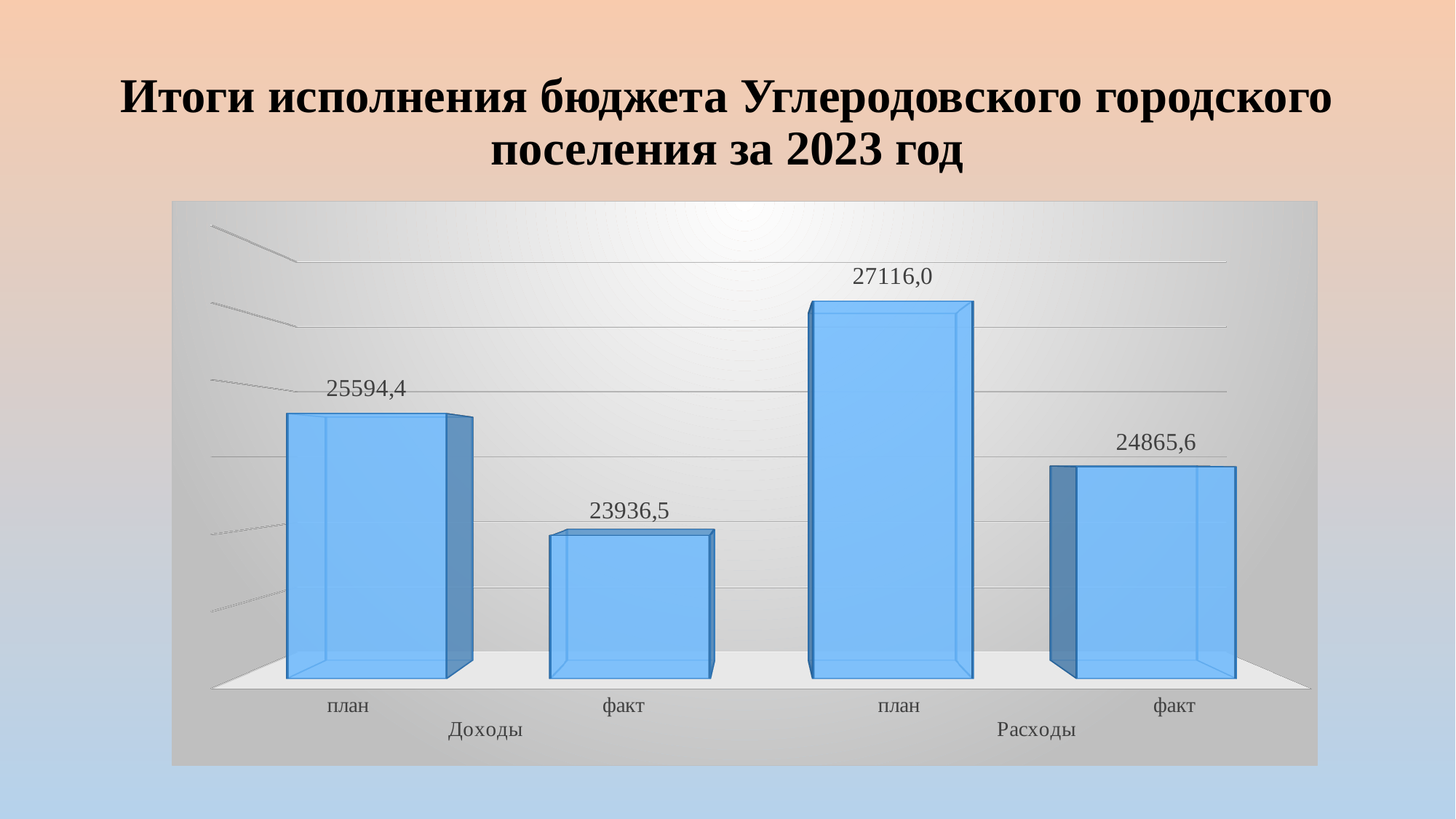
What is the title of the slide? Итоги исполнения бюджета Углеродовского городского поселения за 2023 год What is the value of the факт bar for Расходы? 24865,6 What is the value of the план bar for Доходы? 25594,4 What is the value of the факт bar for Доходы? 23936,5 What is the difference between the план and факт values for Расходы? 2250,4 What is the value of the план bar for Расходы? 27116,0 How many bars are plotted in the chart? 4 Which is larger, the факт value for Доходы or the факт value for Расходы? факт for Расходы Which bar has the highest value? Расходы план What kind of chart is shown on the slide? Bar chart What is the difference between the план and факт values for Доходы? 1657,9 Which bar has the lowest value? Доходы факт